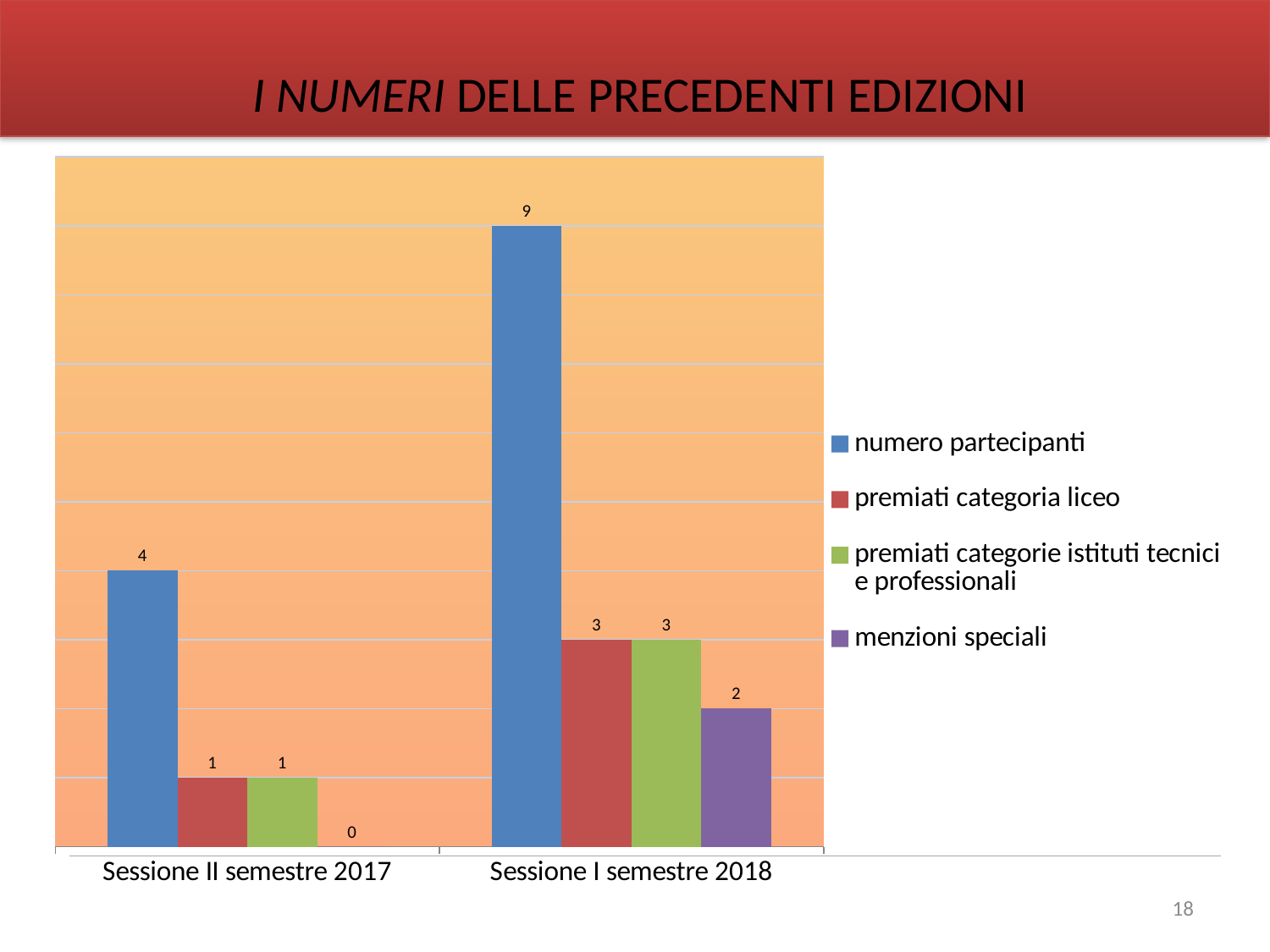
What is the value for 'menzioni speciali' in Sessione I semestre 2018? 2 What kind of chart is shown on the slide? Bar chart What is the difference in 'premiati categoria liceo' between Sessione I semestre 2018 and Sessione II semestre 2017? 2 Which session has the higher value for 'numero partecipanti'? Sessione I semestre 2018 How many sessions (categories) are shown on the x axis? 2 What is the difference in 'numero partecipanti' between Sessione I semestre 2018 and Sessione II semestre 2017? 5 What is the value for 'numero partecipanti' in Sessione I semestre 2018? 9 What is the value for 'menzioni speciali' in Sessione II semestre 2017? 0 What is the value for 'numero partecipanti' in Sessione II semestre 2017? 4 What is the value for 'premiati categoria liceo' in Sessione I semestre 2018? 3 Which colour represents 'menzioni speciali' in the legend? Purple How many series does the legend list? 4